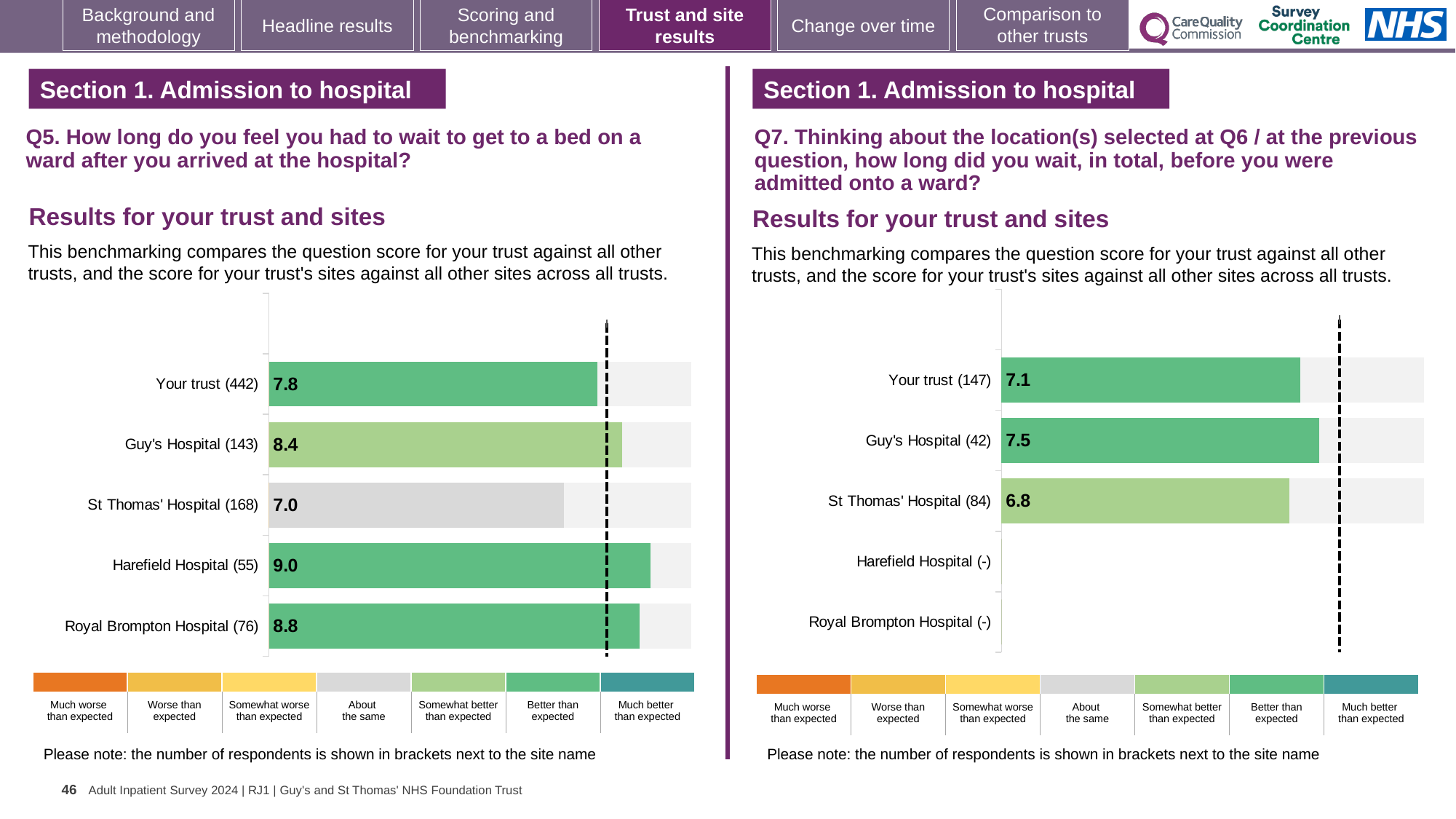
On the Q7 chart (right), which site with a score shown has the lowest score? St Thomas' Hospital On the Q7 chart (right), how many respondents are shown in brackets for Your trust? 147 What type of chart is used on the Q5 chart (left)? Bar chart On the Q5 chart (left), which site has the lowest score? St Thomas' Hospital On the Q7 chart (right), what is the score for Guy's Hospital? 7.5 On the Q5 chart (left), what is the score for Harefield Hospital? 9.0 On the Q5 chart (left), which site has the highest score? Harefield Hospital On the Q5 chart (left), what is the score for St Thomas' Hospital? 7.0 On the Q7 chart (right), what is the difference between the scores for Guy's Hospital and St Thomas' Hospital? 0.7 On the Q7 chart (right), what is the score for Your trust? 7.1 On the Q5 chart (left), what is the difference between the scores for Harefield Hospital and Your trust? 1.2 On the Q5 chart (left), which has the higher score, Guy's Hospital or Royal Brompton Hospital? Royal Brompton Hospital